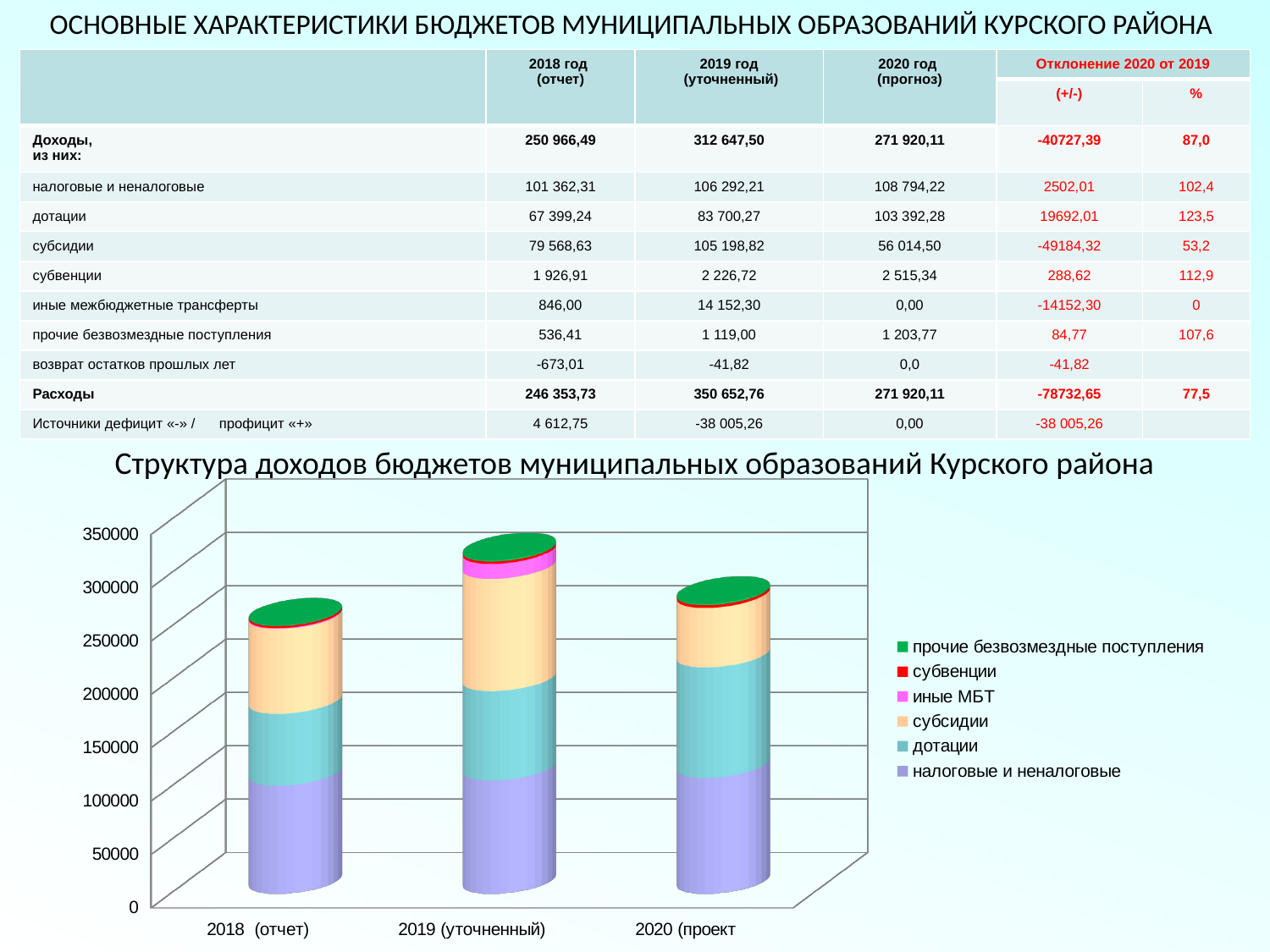
Which stacked bar is taller: 2019 (уточненный) or 2020 (проект)? 2019 (уточненный) Is the total stacked bar for 2019 (уточненный) greater or less than 300000? greater Which series forms the bottom segment of each stacked bar in the chart? налоговые и неналоговые How many series does the chart legend list? 6 Do the stacked bar totals rise or fall from 2019 (уточненный) to 2020 (проект)? fall What is the title of the chart on the slide? Структура доходов бюджетов муниципальных образований Курского района Is the total stacked bar for 2018 (отчет) greater or less than 200000? greater How many bars (categories) are plotted on the x axis of the chart? 3 Which category has the tallest stacked bar in the chart? 2019 (уточненный) Which category has the shortest stacked bar in the chart? 2018 (отчет) What kind of chart is shown under the title 'Структура доходов бюджетов муниципальных образований Курского района'? bar chart